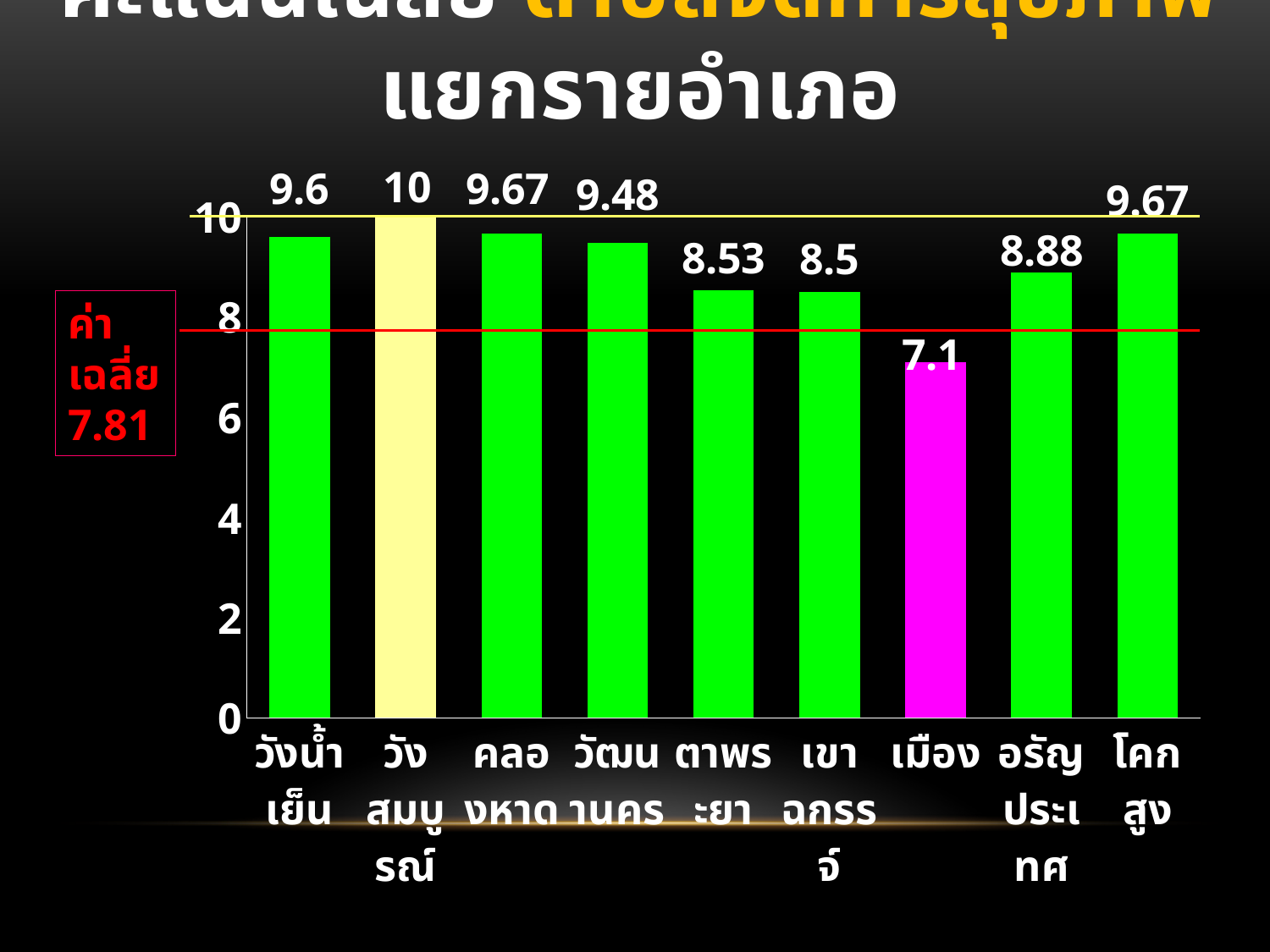
Which district has the highest value? วังสมบูรณ์ What is the value for อรัญประเทศ? 8.88 What average value (ค่าเฉลี่ย) is shown in the red box on the slide? 7.81 What is the value for วังสมบูรณ์? 10 Which district has the lowest value? เมือง What is the difference between the values for วังสมบูรณ์ and เมือง? 2.9 What kind of chart is shown on the slide? bar chart How many districts are shown on the chart? 9 Which is larger, the value for วังน้ำเย็น or the value for วัฒนานคร? วังน้ำเย็น What is the value for ตาพระยา? 8.53 What is the value for เมือง? 7.1 Is the value for เมือง greater or less than 8? less